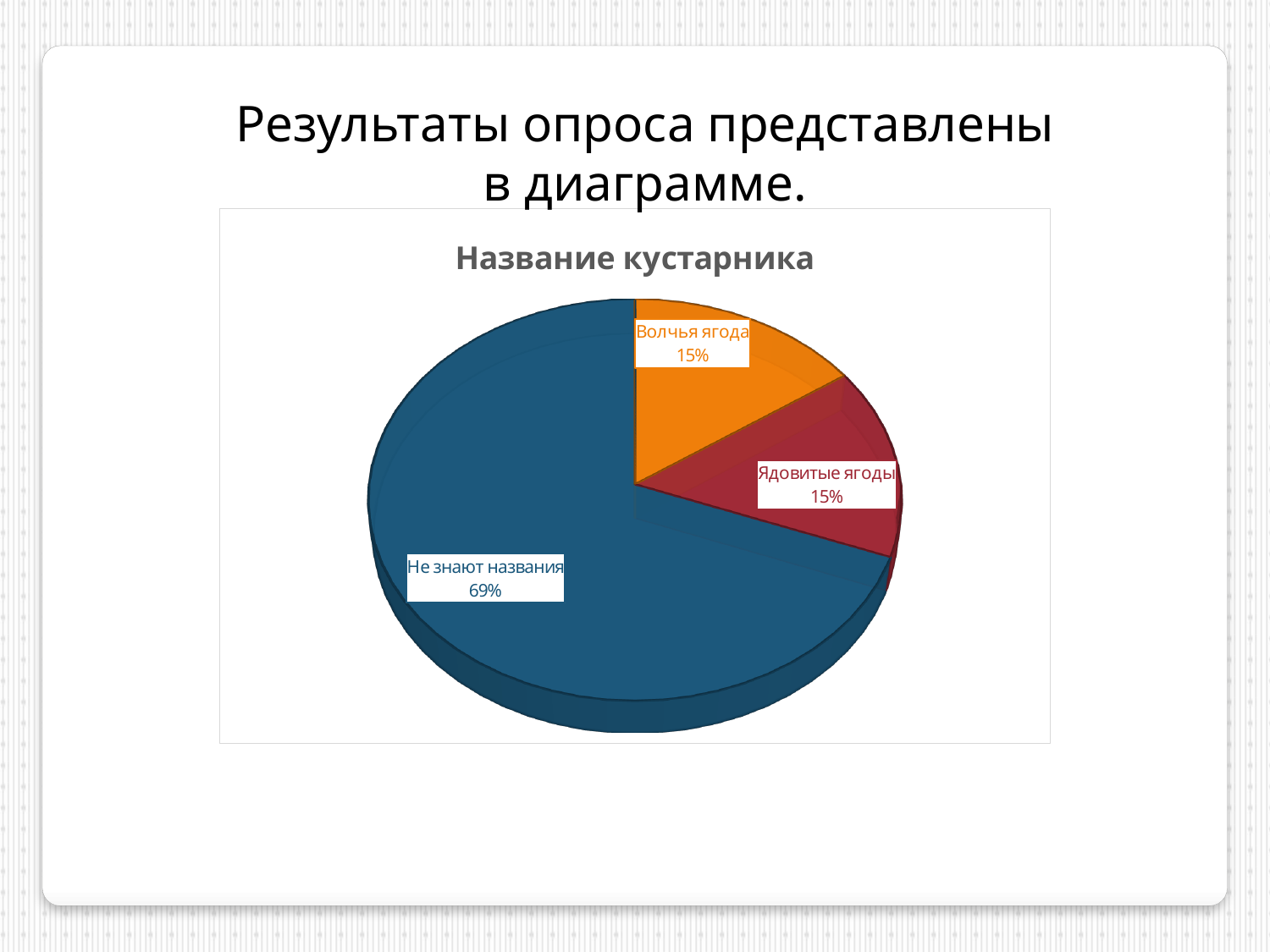
What is the combined share of "Волчья ягода" and "Ядовитые ягоды"? 30% Which slice of the pie is the largest? Не знают названия How many slices does the pie chart have? 3 Which is larger, the share for "Не знают названия" or the share for "Ядовитые ягоды"? Не знают названия What colour is the slice labelled "Волчья ягода"? orange What is the difference in percentage points between "Не знают названия" and "Волчья ягода"? 54 What type of chart is shown on the slide? pie chart What is the title of the chart? Название кустарника What share of the pie is labelled "Не знают названия"? 69% What share of the pie is labelled "Волчья ягода"? 15% What share of the pie is labelled "Ядовитые ягоды"? 15%